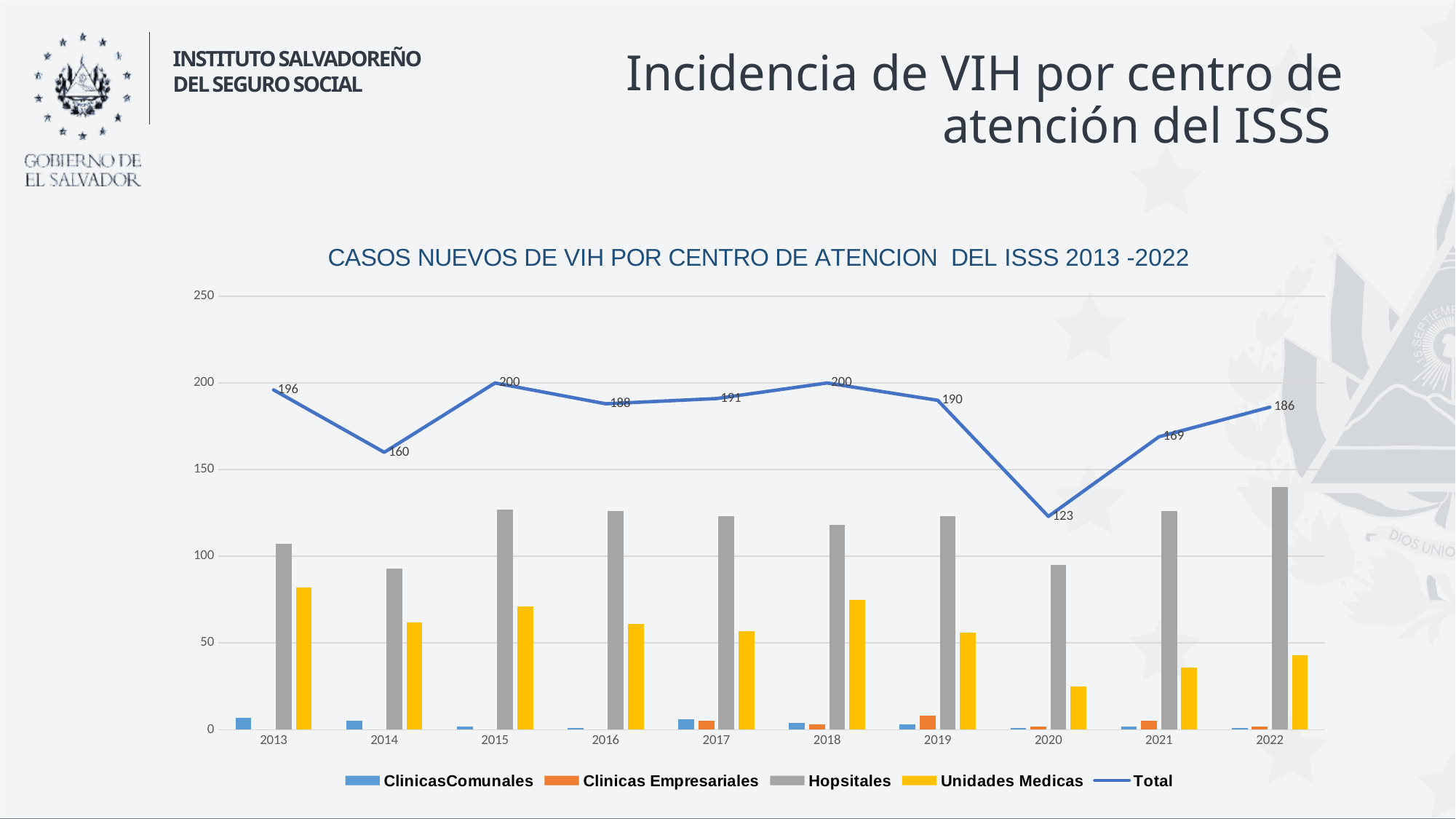
What is the Total value for 2014? 160 Is the value for Hopsitales in 2022 greater or less than 100? greater What is the difference between the Total for 2019 and the Total for 2020? 67 What kind of chart is this? Combination bar and line chart In which year is the Total lowest? 2020 Which years share the highest Total value of 200? 2015 and 2018 How many years are shown on the x axis? 10 How many series does the legend list? 5 What is the Total value for 2022? 186 What is the Total value for 2020? 123 Which year has the larger Total, 2021 or 2022? 2022 Is the value for Unidades Medicas in 2020 greater or less than 50? less